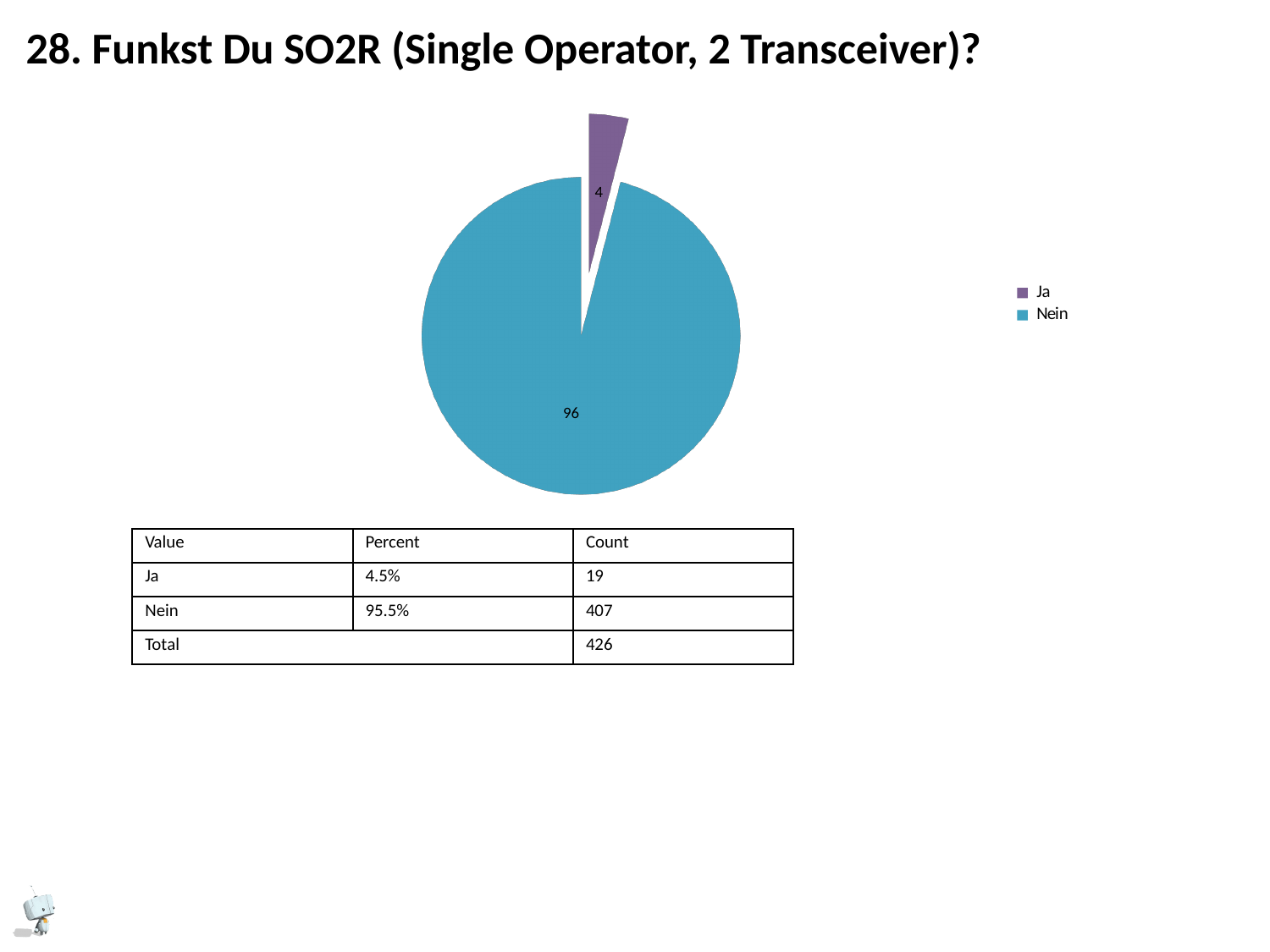
What is the data label shown on the Nein slice of the pie chart? 96 Which category has the smallest slice in the pie chart? Ja What is the data label shown on the Ja slice of the pie chart? 4 How many slices does the pie chart have? 2 What kind of chart is shown on the slide? pie chart Which category has the largest slice in the pie chart? Nein What colour is the Nein slice in the pie chart? blue What is the difference between the data labels of the Nein slice and the Ja slice? 92 Which slice is larger, Ja or Nein? Nein How many entries does the legend list? 2 What colour is the Ja slice in the pie chart? purple